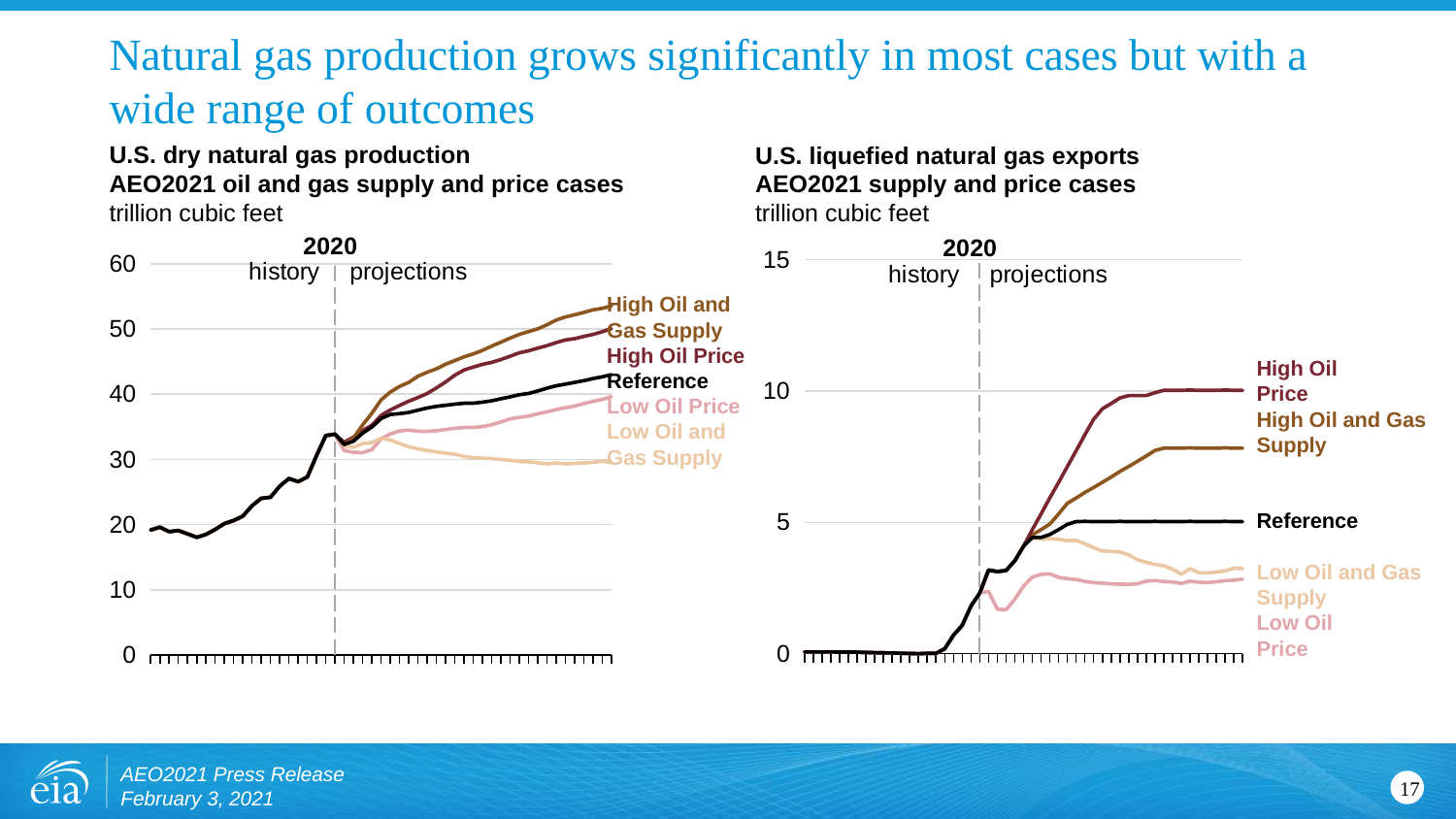
On the U.S. liquefied natural gas exports chart, is the Low Oil Price value at the end of the projection greater or less than 5? less On the U.S. liquefied natural gas exports chart, which is higher at the end of the projection: High Oil and Gas Supply or Reference? High Oil and Gas Supply On the U.S. dry natural gas production chart, which case has the highest value at the end of the projection period? High Oil and Gas Supply On the U.S. dry natural gas production chart, is the High Oil and Gas Supply value at the end of the projection greater or less than 50? greater On the U.S. liquefied natural gas exports chart, which case has the highest value at the end of the projection period? High Oil Price On the U.S. dry natural gas production chart, do values generally rise or fall over the history period up to 2020? rise On the U.S. dry natural gas production chart, is the Reference case value at the end of the projection greater or less than 40? greater On the U.S. dry natural gas production chart, which case has the lowest value at the end of the projection period? Low Oil and Gas Supply What kind of chart is the U.S. dry natural gas production chart? line chart What unit is used on the y axis of both charts? trillion cubic feet How many cases (series) are shown on the U.S. liquefied natural gas exports chart? 5